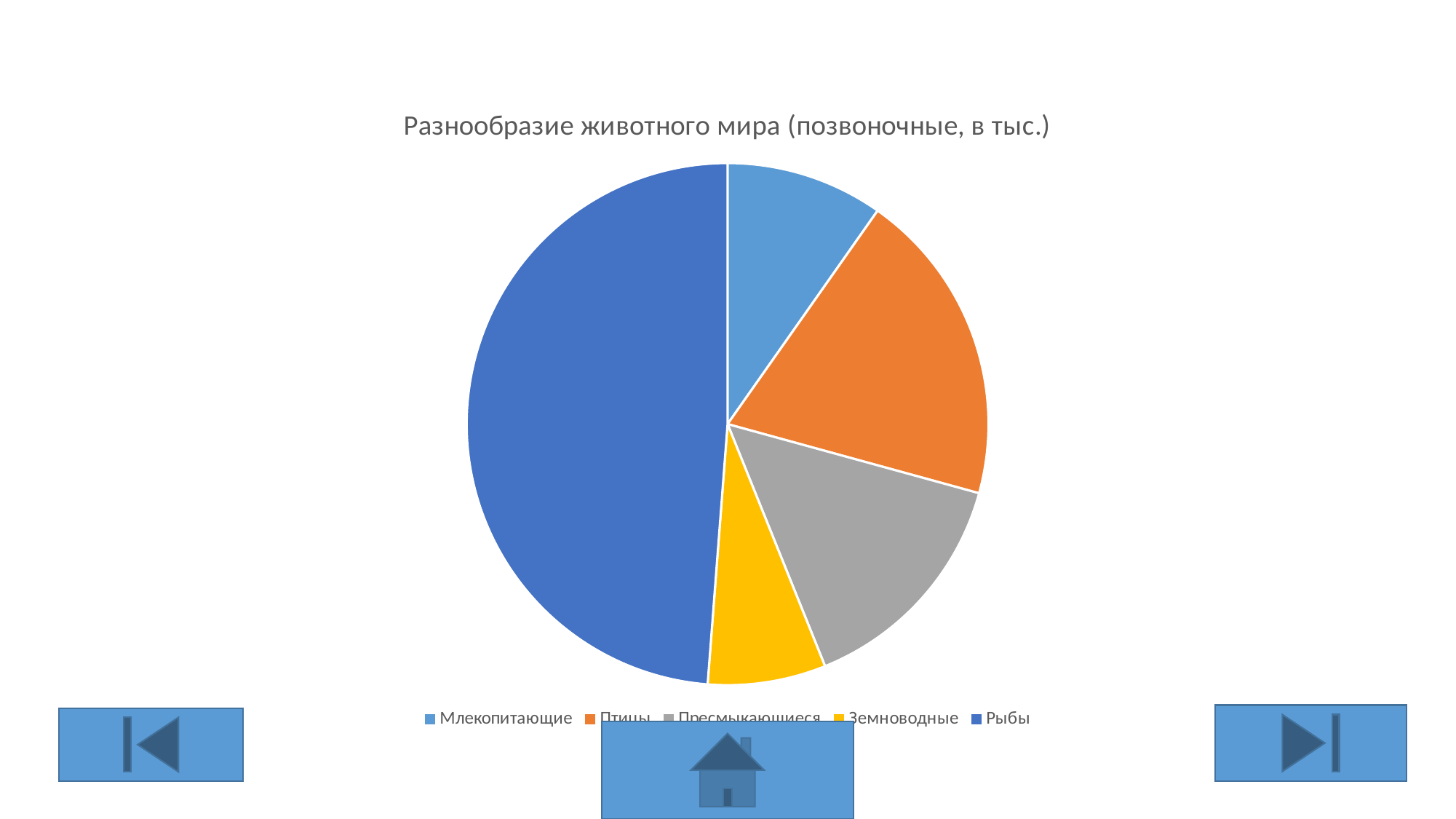
Which slice is larger, Птицы or Млекопитающие? Птицы Which slice is larger, Рыбы or Птицы? Рыбы Which category has the largest slice of the pie? Рыбы What is the title of the chart? Разнообразие животного мира (позвоночные, в тыс.) What kind of chart is shown on the slide? pie chart Which colour represents Земноводные in the pie chart? yellow How many categories does the pie chart have? 5 How many entries does the legend list? 5 Which slice is larger, Пресмыкающиеся or Земноводные? Пресмыкающиеся